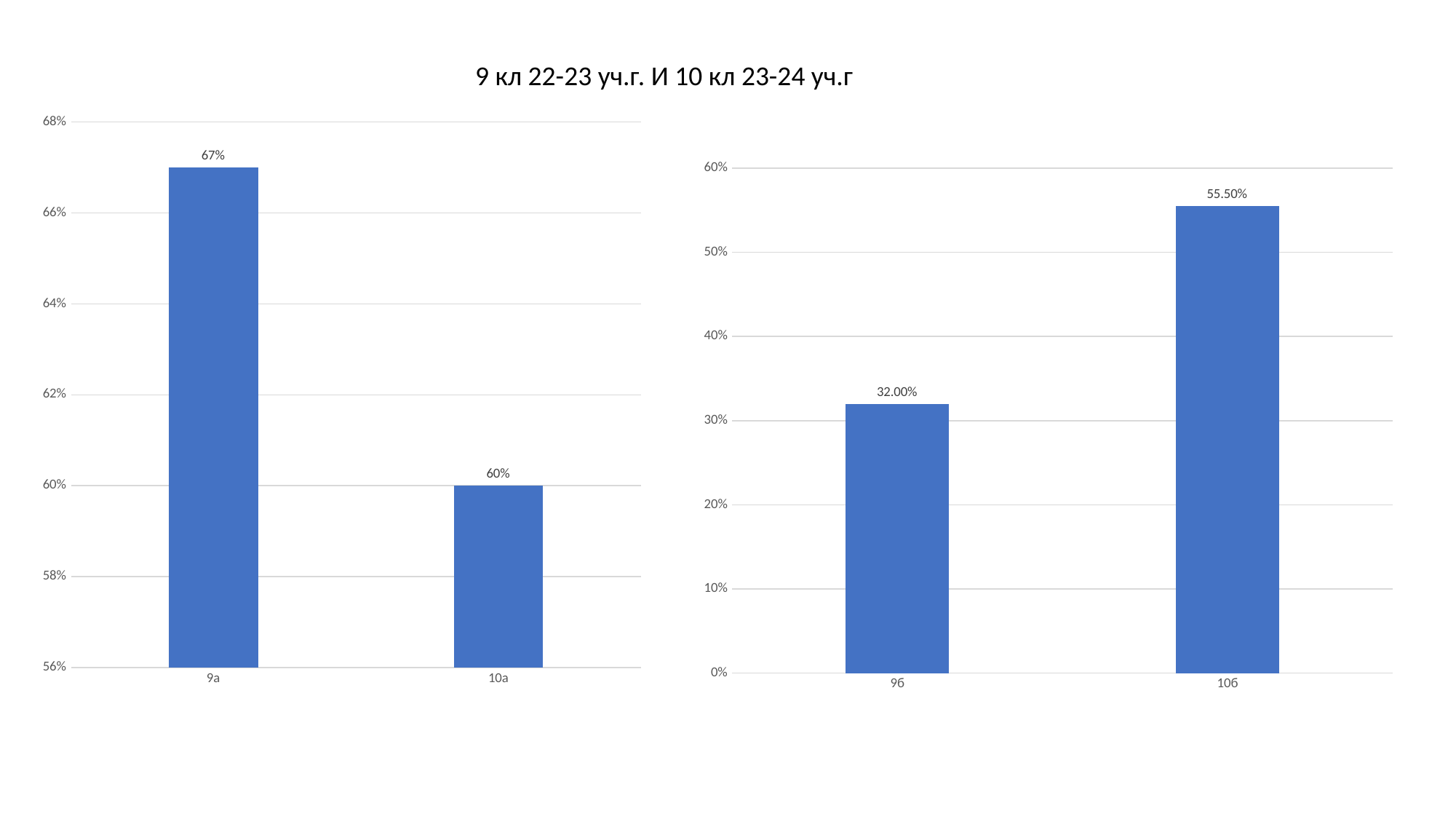
In the right chart, which category has the lower value? 9б In the right chart, what is the value for 10б? 55.50% In the left chart, what is the value for 9а? 67% How many bars does the right chart show? 2 In the left chart, what is the difference between the values for 9а and 10а? 7% What kind of chart is the left chart? bar chart In the right chart, what is the difference between the values for 10б and 9б? 23.50% In the right chart, what is the value for 9б? 32.00% In the left chart, what is the value for 10а? 60% In the right chart, is the value for 10б greater or less than 50%? greater In the left chart, which category has the higher value? 9а What is the title shown above the charts on the slide? 9 кл 22-23 уч.г. И 10 кл 23-24 уч.г